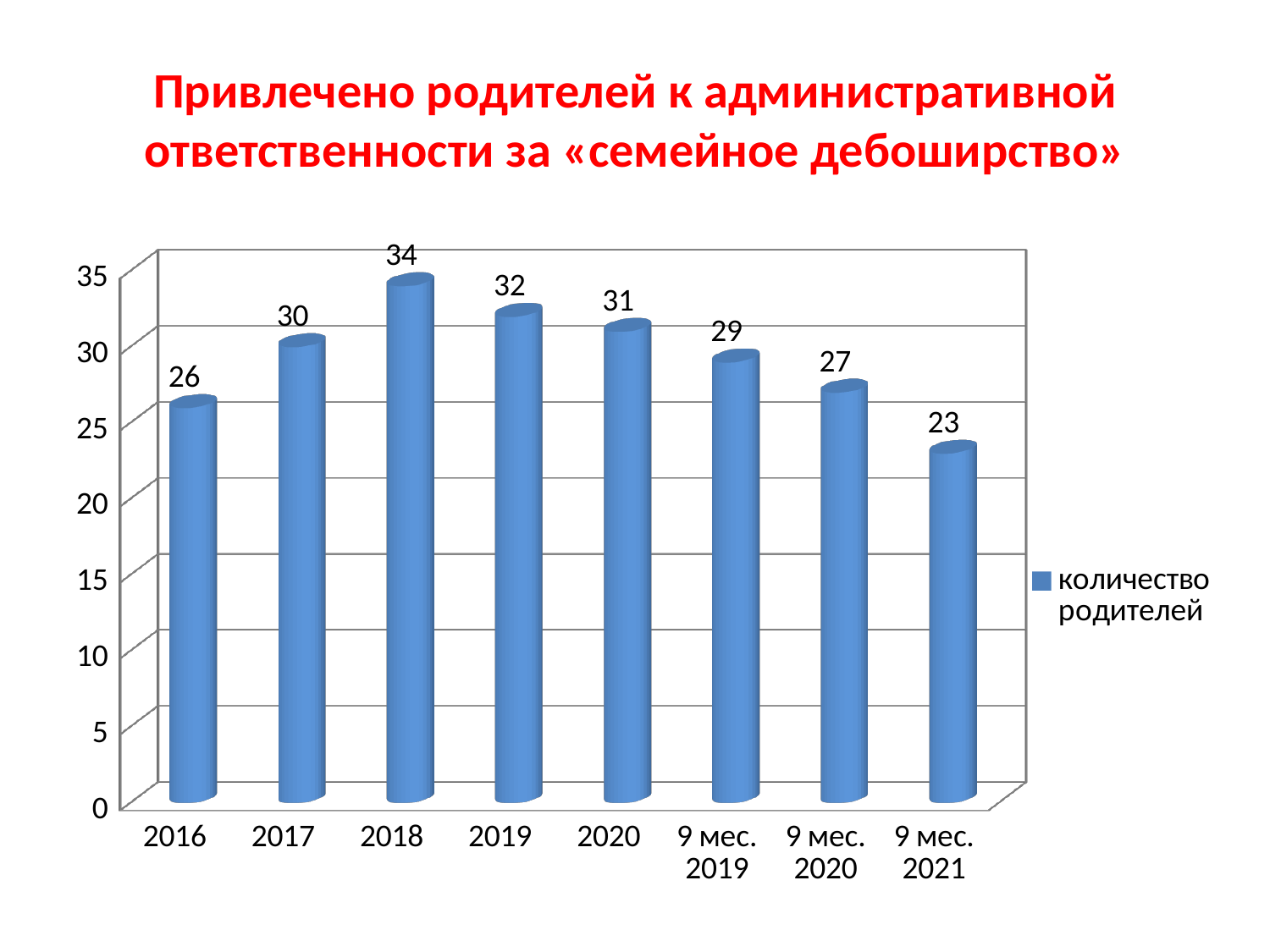
Which category has the lowest value? 9 мес. 2021 How many series does the legend list? 1 What is the difference between the values for 2018 and 2016? 8 What kind of chart is shown? bar chart What is the value for 2018? 34 Which category has the highest value? 2018 What is the value for 2016? 26 What is the difference between the values for 9 мес. 2020 and 9 мес. 2021? 4 What is the value for 9 мес. 2021? 23 Which is larger, the value for 2017 or the value for 2020? 2020 How many categories are shown on the x axis? 8 Is the value for 2019 greater or less than 30? greater